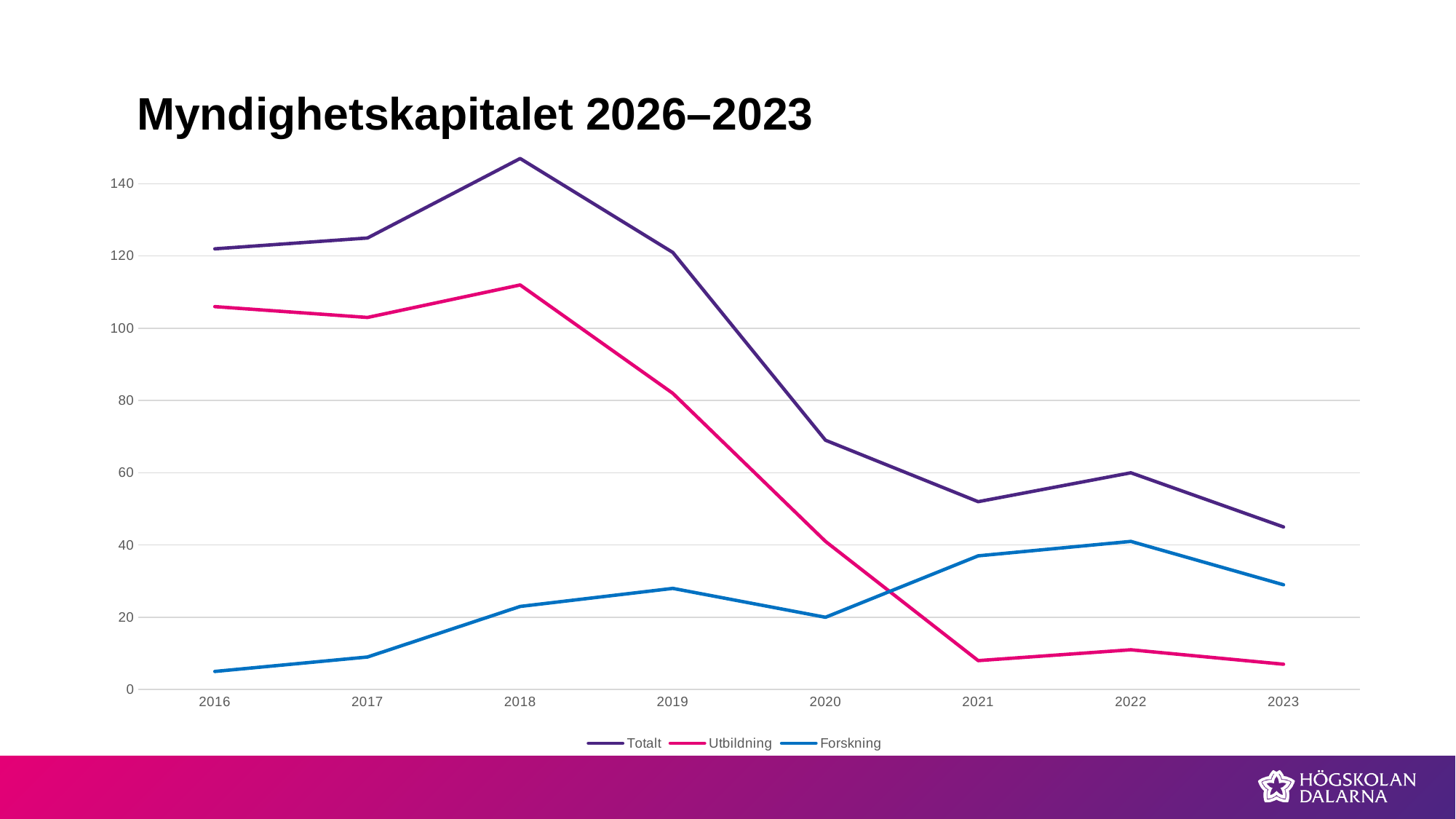
In which year does the Totalt series reach its highest value? 2018 How many years are plotted along the x axis? 8 In which year is the Totalt series at its lowest? 2023 In which year does the Forskning series reach its highest value? 2022 Which is larger in 2023, Utbildning or Forskning? Forskning How many series does the legend list? 3 In which year is the Forskning series at its lowest? 2016 Does the Totalt series rise or fall from 2018 to 2021? fall Is the value for Totalt in 2020 greater or less than 60? greater Is the value for Utbildning in 2021 greater or less than 20? less What kind of chart is shown on the slide? line chart Is the value for Totalt in 2018 greater or less than 140? greater